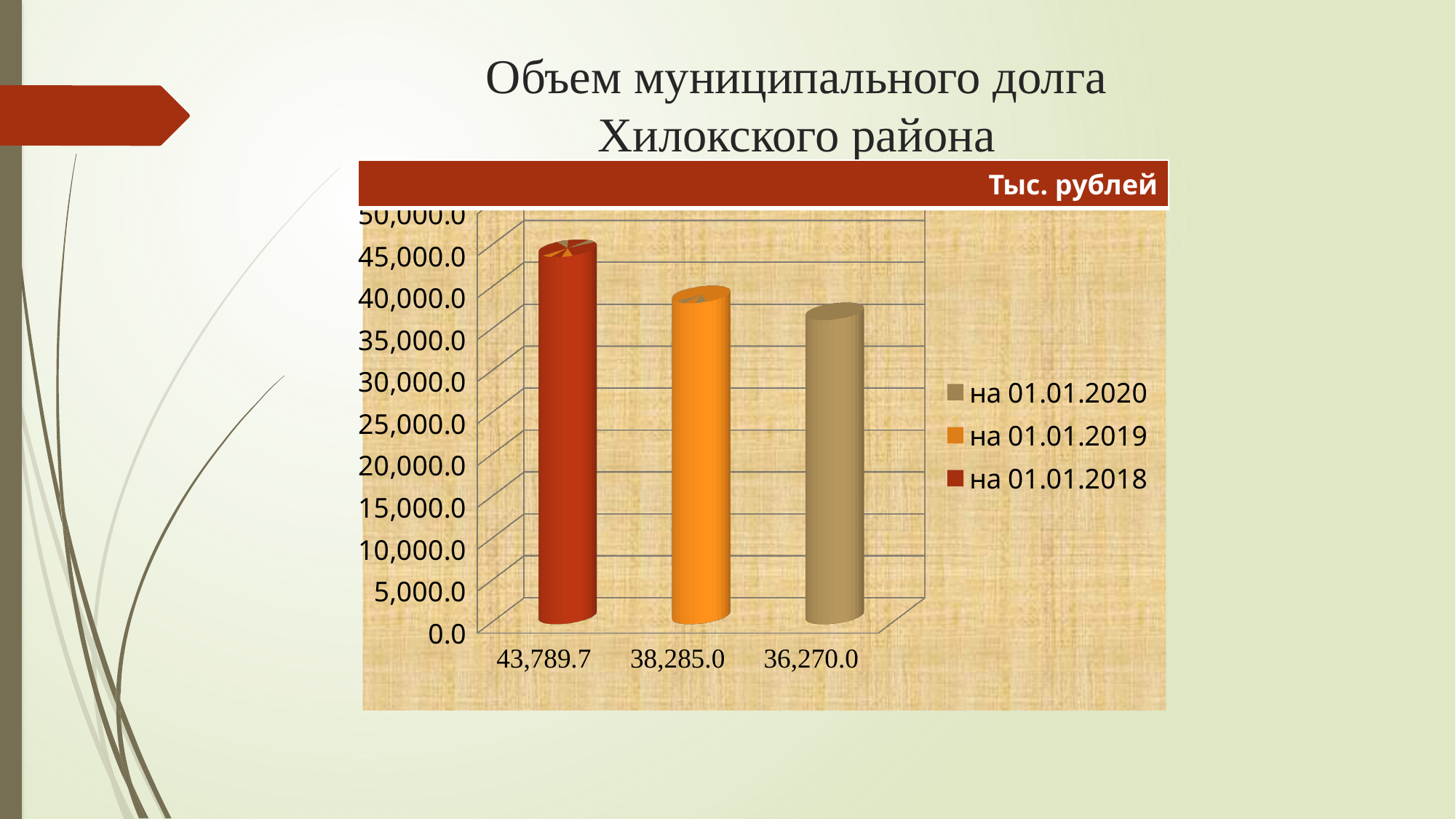
What type of chart is shown on the slide? Bar chart What is the value of municipal debt as of 01.01.2018 (на 01.01.2018)? 43,789.7 Do the values rise or fall from 01.01.2018 to 01.01.2020? fall Which date has the lowest municipal debt value? на 01.01.2020 Which is larger: the debt as of 01.01.2019 or as of 01.01.2020? на 01.01.2019 What is the value of municipal debt as of 01.01.2019 (на 01.01.2019)? 38,285.0 What is the difference between the debt as of 01.01.2018 and as of 01.01.2019? 5,504.7 How many series does the legend list? 3 What is the value of municipal debt as of 01.01.2020 (на 01.01.2020)? 36,270.0 What is the difference between the debt as of 01.01.2019 and as of 01.01.2020? 2,015.0 Is the value for 01.01.2020 greater or less than 40,000.0? less Which date has the highest municipal debt value? на 01.01.2018